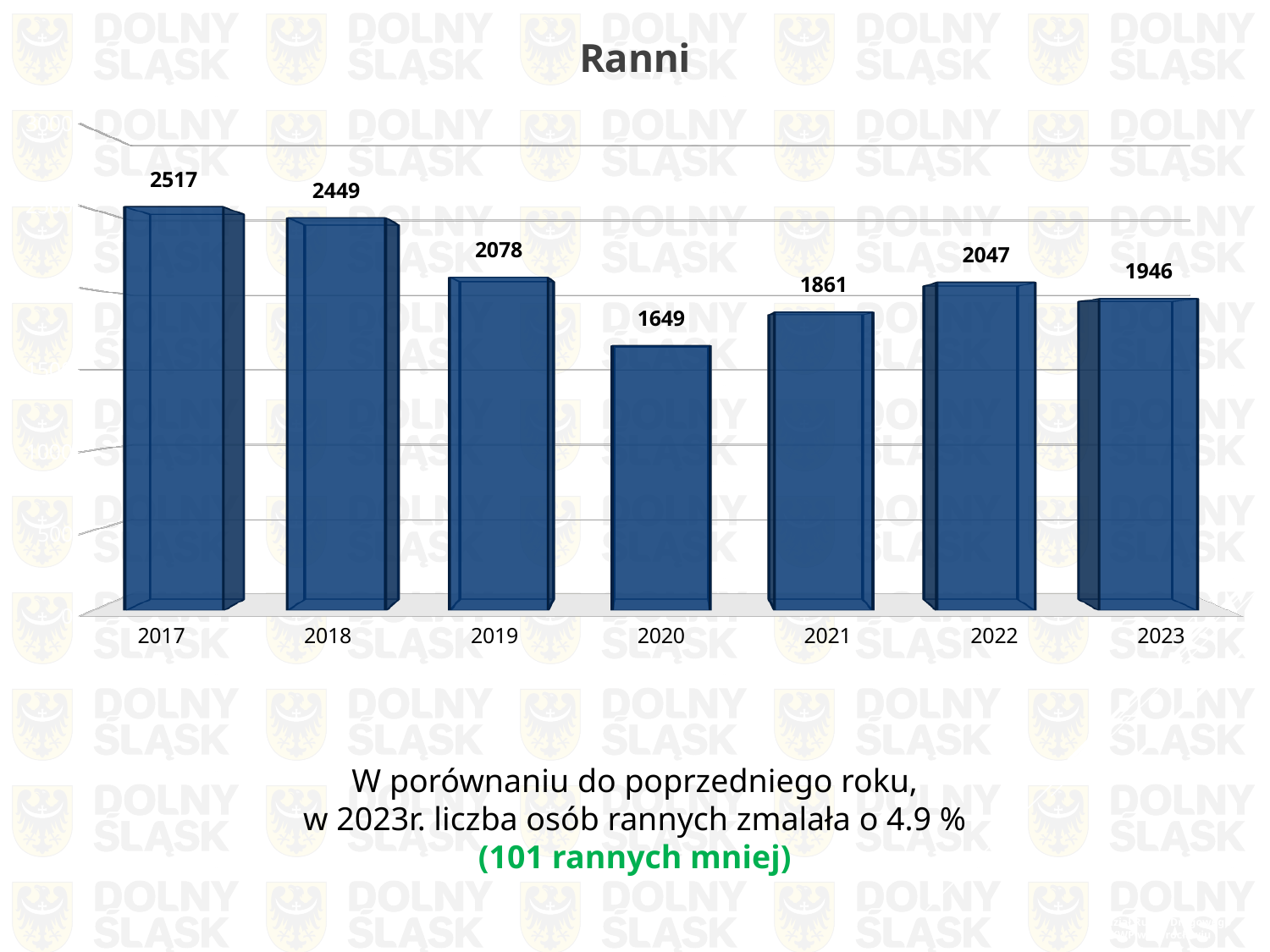
What is the difference between the values for 2022 and 2023? 101 What is the value for 2020? 1649 What is the difference between the values for 2017 and 2018? 68 What is the title of the chart? Ranni Which is larger, the value for 2019 or the value for 2021? 2019 Which year has the highest value? 2017 What is the value for 2023? 1946 How many years are shown on the x axis? 7 What is the value for 2017? 2517 Do the values rise or fall from 2017 to 2020? fall Which year has the lowest value? 2020 What kind of chart is shown? bar chart